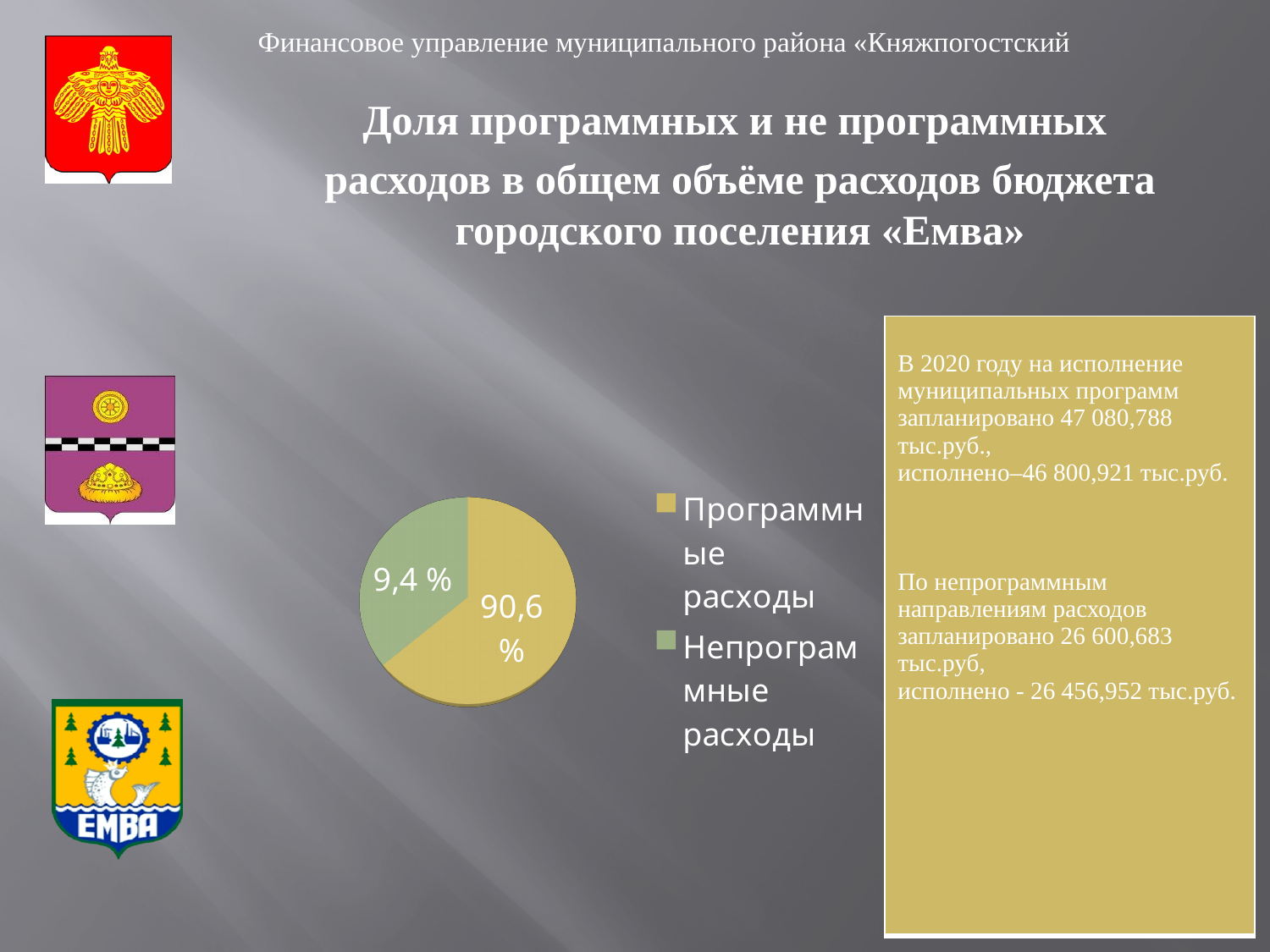
Which is larger: the slice for Программные расходы or the slice for Непрограммные расходы? Программные расходы Which category has the largest slice in the pie chart? Программные расходы What is the difference in percentage points between the Программные расходы slice and the Непрограммные расходы slice? 81,2 % How many slices does the pie chart have? 2 What kind of chart is shown on the slide? pie chart What value is printed on the larger slice of the pie chart? 90,6 % Which category has the smallest slice in the pie chart? Непрограммные расходы What value is printed on the smaller slice of the pie chart? 9,4 % Which legend entry is shown in green in the pie chart? Непрограммные расходы What share of the pie does the slice for Непрограммные расходы take? 9,4 % What share of the pie does the slice for Программные расходы take? 90,6 % How many entries does the chart legend list? 2